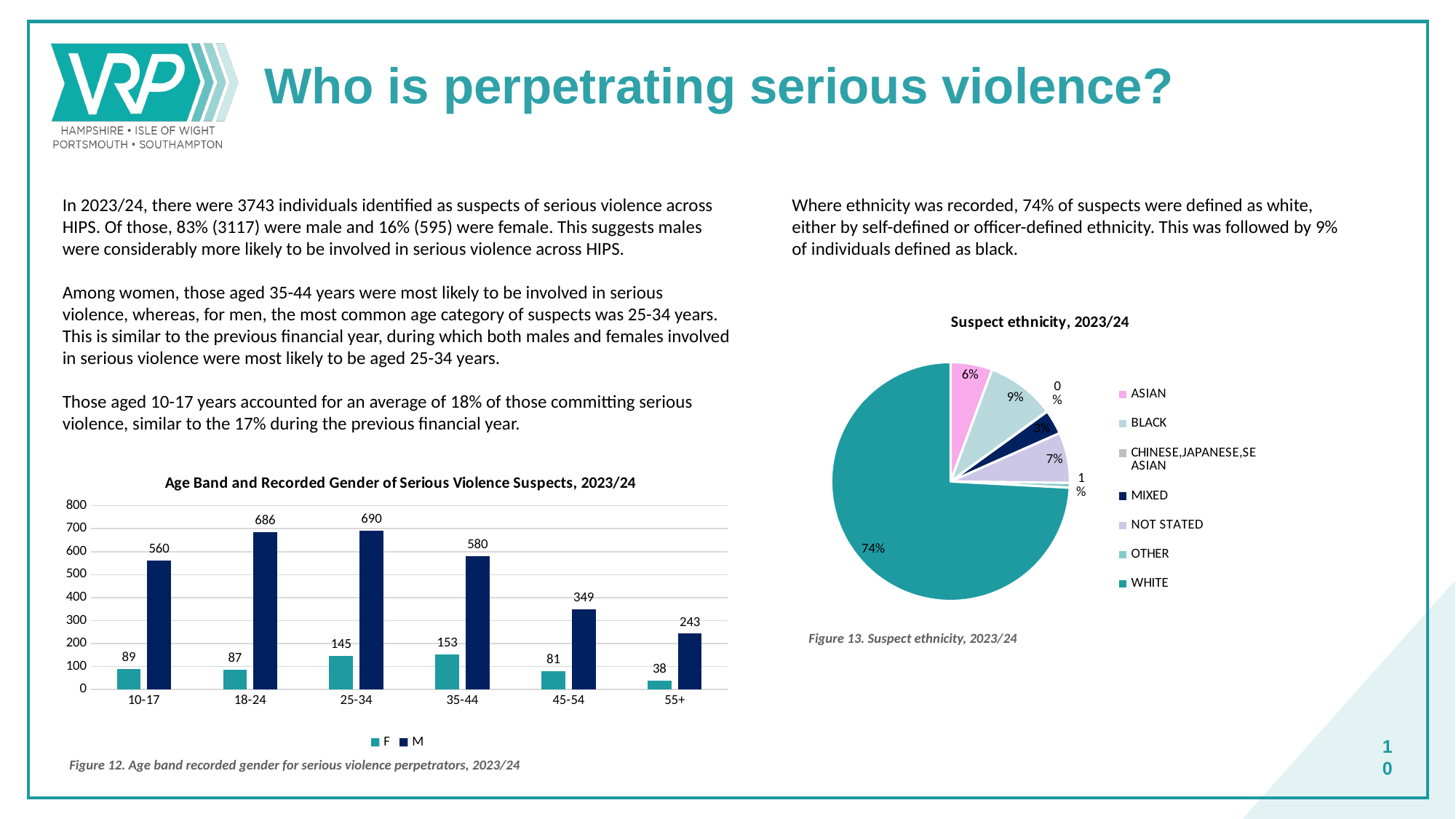
How many age bands are shown in the 'Age Band and Recorded Gender of Serious Violence Suspects, 2023/24' chart? 6 In the 'Age Band and Recorded Gender of Serious Violence Suspects, 2023/24' chart, what is the value for M in the 25-34 age band? 690 What kind of chart is the 'Age Band and Recorded Gender of Serious Violence Suspects, 2023/24' chart? Bar chart In the 'Suspect ethnicity, 2023/24' chart, what share of suspects were defined as BLACK? 9% How many series does the legend of the 'Age Band and Recorded Gender of Serious Violence Suspects, 2023/24' chart list? 2 In the 'Age Band and Recorded Gender of Serious Violence Suspects, 2023/24' chart, which age band has the lowest value for M? 55+ In the 'Age Band and Recorded Gender of Serious Violence Suspects, 2023/24' chart, what is the value for F in the 35-44 age band? 153 In the 'Suspect ethnicity, 2023/24' chart, which ethnicity has the largest slice? WHITE In the 'Age Band and Recorded Gender of Serious Violence Suspects, 2023/24' chart, what is the difference between the M and F values in the 18-24 age band? 599 In the 'Age Band and Recorded Gender of Serious Violence Suspects, 2023/24' chart, is the F value for 10-17 or for 18-24 larger? 10-17 In the 'Age Band and Recorded Gender of Serious Violence Suspects, 2023/24' chart, which age band has the highest value for F? 35-44 What kind of chart is the 'Suspect ethnicity, 2023/24' chart? Pie chart